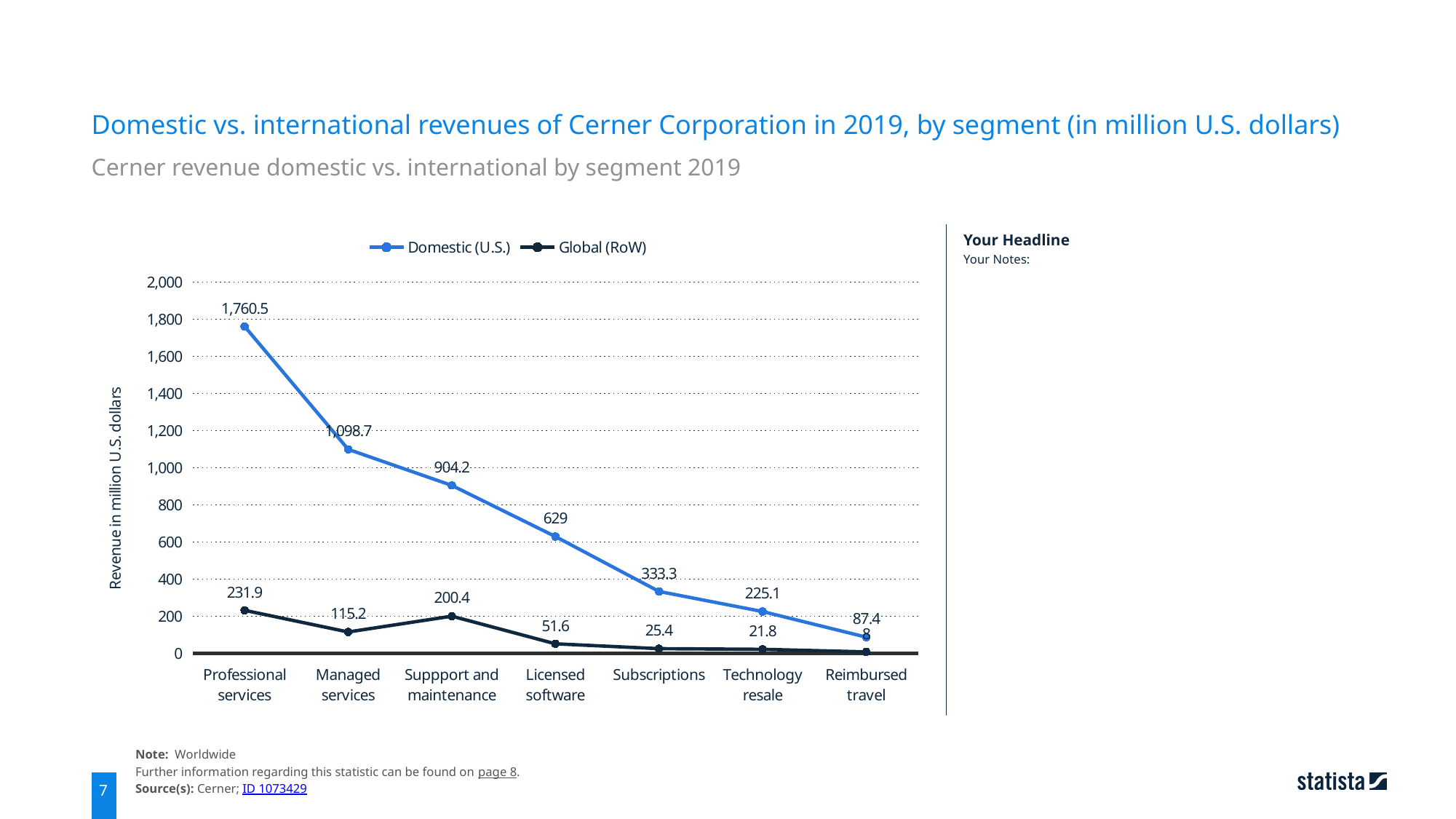
Which segment has the lowest Global (RoW) revenue? Reimbursed travel How many series does the legend list? 2 What is the difference between the Domestic (U.S.) and Global (RoW) revenue for Subscriptions? 307.9 What is the Domestic (U.S.) revenue for Professional services? 1,760.5 What is the Global (RoW) revenue for Suppport and maintenance? 200.4 How many segments are shown on the x axis? 7 What type of chart is shown on the slide? Line chart What is the Global (RoW) revenue for Reimbursed travel? 8 Which segment has the highest Domestic (U.S.) revenue? Professional services Does the Domestic (U.S.) revenue rise or fall from Professional services to Reimbursed travel? Fall What is the Domestic (U.S.) revenue for Licensed software? 629 Which is larger for Managed services: the Domestic (U.S.) revenue or the Global (RoW) revenue? Domestic (U.S.)